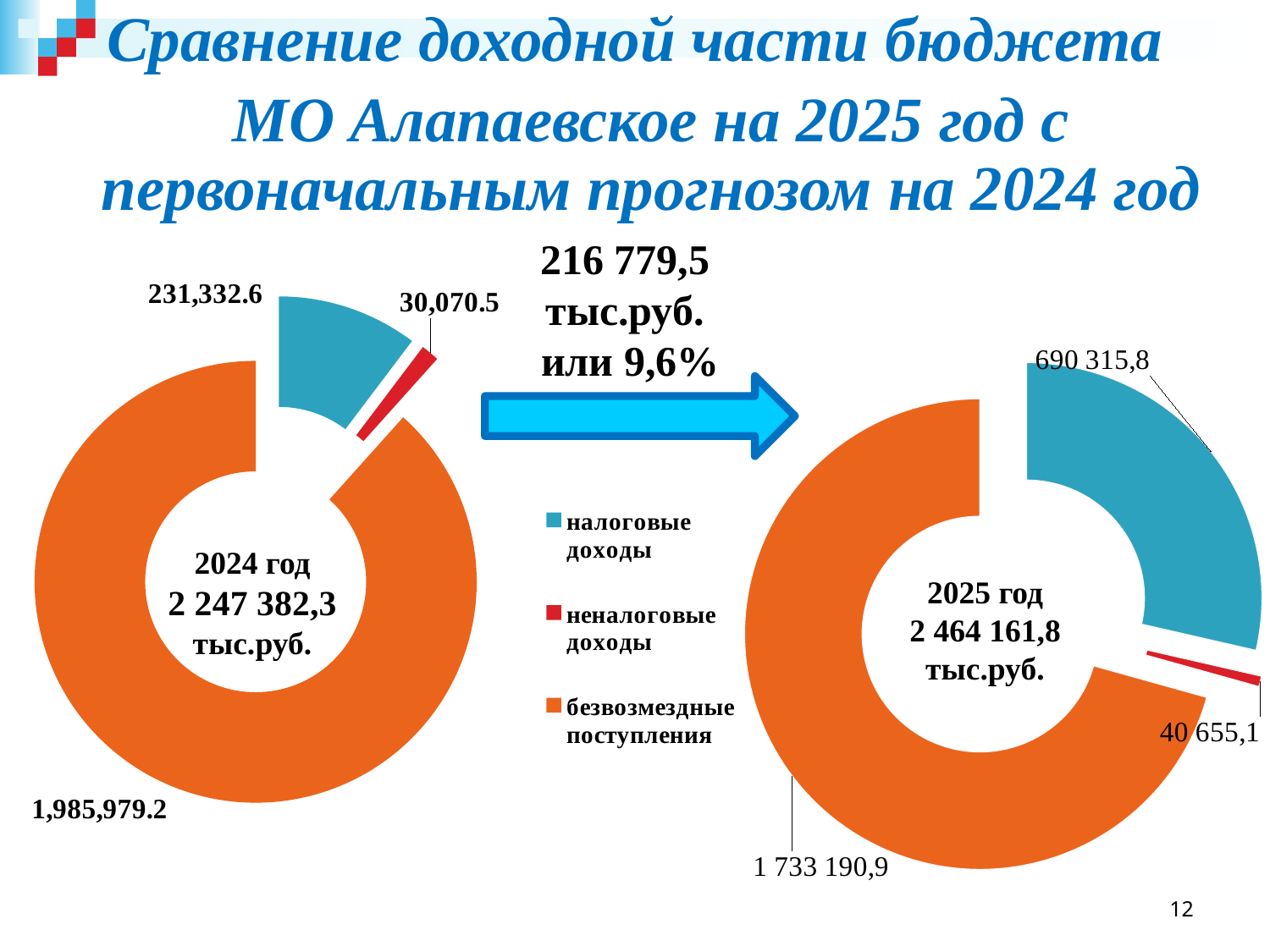
What is the total shown in the centre of the 2025 год chart? 2 464 161,8 тыс.руб. On the 2025 год chart, what is the value for безвозмездные поступления? 1 733 190,9 Which colour represents безвозмездные поступления in the legend? orange On the 2024 год chart, which category has the largest value? безвозмездные поступления On the 2024 год chart, what is the difference between налоговые доходы and неналоговые доходы? 201,262.1 What kind of chart is the 2024 год chart? doughnut chart On the 2025 год chart, what is the difference between налоговые доходы and неналоговые доходы? 649 660,7 Which is larger: налоговые доходы on the 2024 год chart or налоговые доходы on the 2025 год chart? 2025 год How many categories does the 2024 год chart show? 3 On the 2025 год chart, what is the value for неналоговые доходы? 40 655,1 On the 2024 год chart, what is the value for налоговые доходы? 231,332.6 On the 2025 год chart, which category has the smallest value? неналоговые доходы